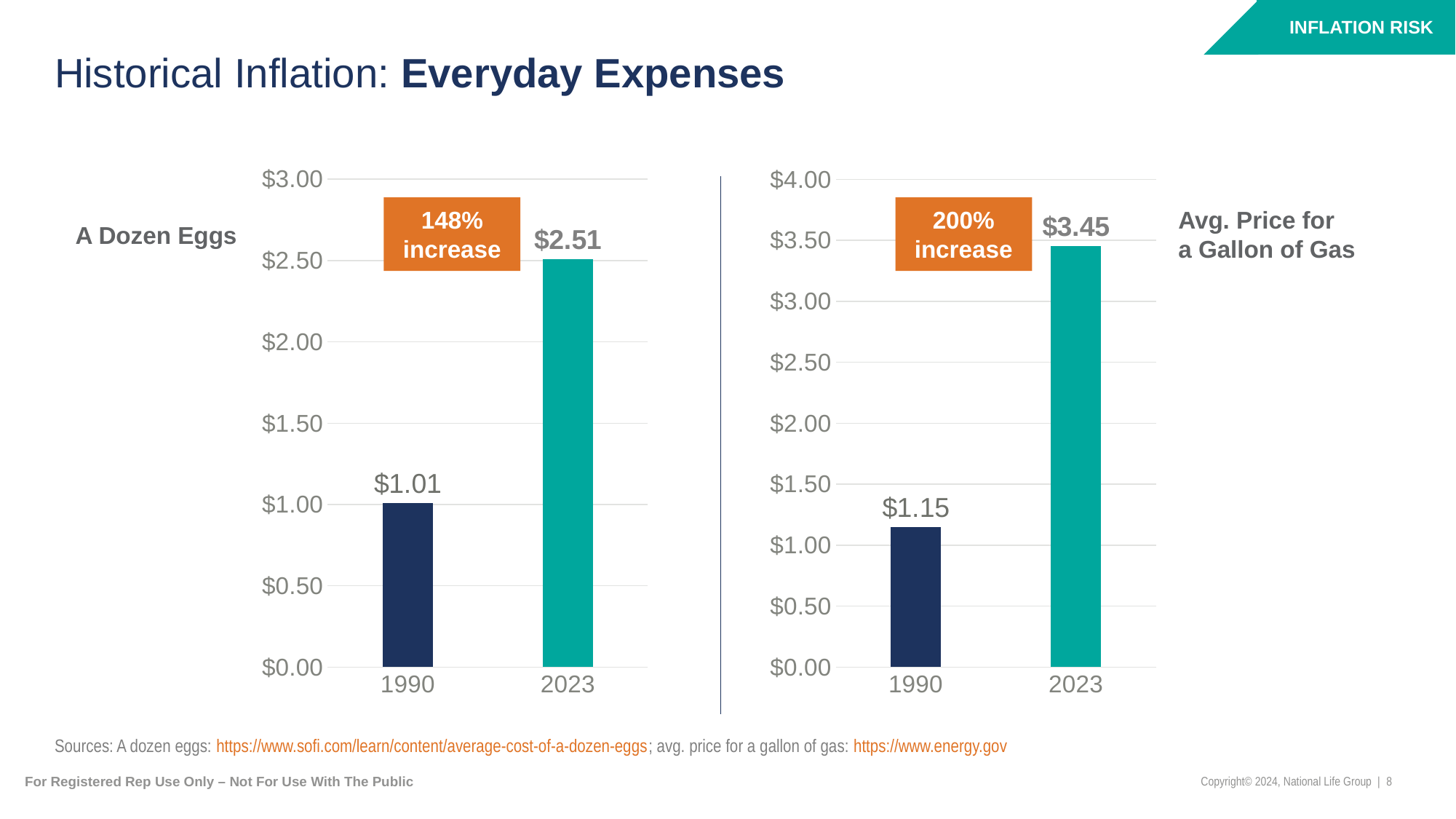
In the 'Avg. Price for a Gallon of Gas' chart, what is the difference between the 2023 and 1990 values? $2.30 What percentage increase is shown in the callout on the 'Avg. Price for a Gallon of Gas' chart? 200% increase In the 'Avg. Price for a Gallon of Gas' chart, what is the value for 1990? $1.15 In the 'A Dozen Eggs' chart, what is the value for 2023? $2.51 In the 'A Dozen Eggs' chart, which year has the higher value? 2023 In the 'A Dozen Eggs' chart, what is the value for 1990? $1.01 In the 'Avg. Price for a Gallon of Gas' chart, which year has the lower value? 1990 In the 'Avg. Price for a Gallon of Gas' chart, what is the value for 2023? $3.45 In the 'Avg. Price for a Gallon of Gas' chart, is the value for 2023 greater or less than $3.00? greater How many bars are in the 'Avg. Price for a Gallon of Gas' chart? 2 What kind of chart is the 'A Dozen Eggs' chart? bar chart In the 'A Dozen Eggs' chart, what is the difference between the 2023 and 1990 values? $1.50